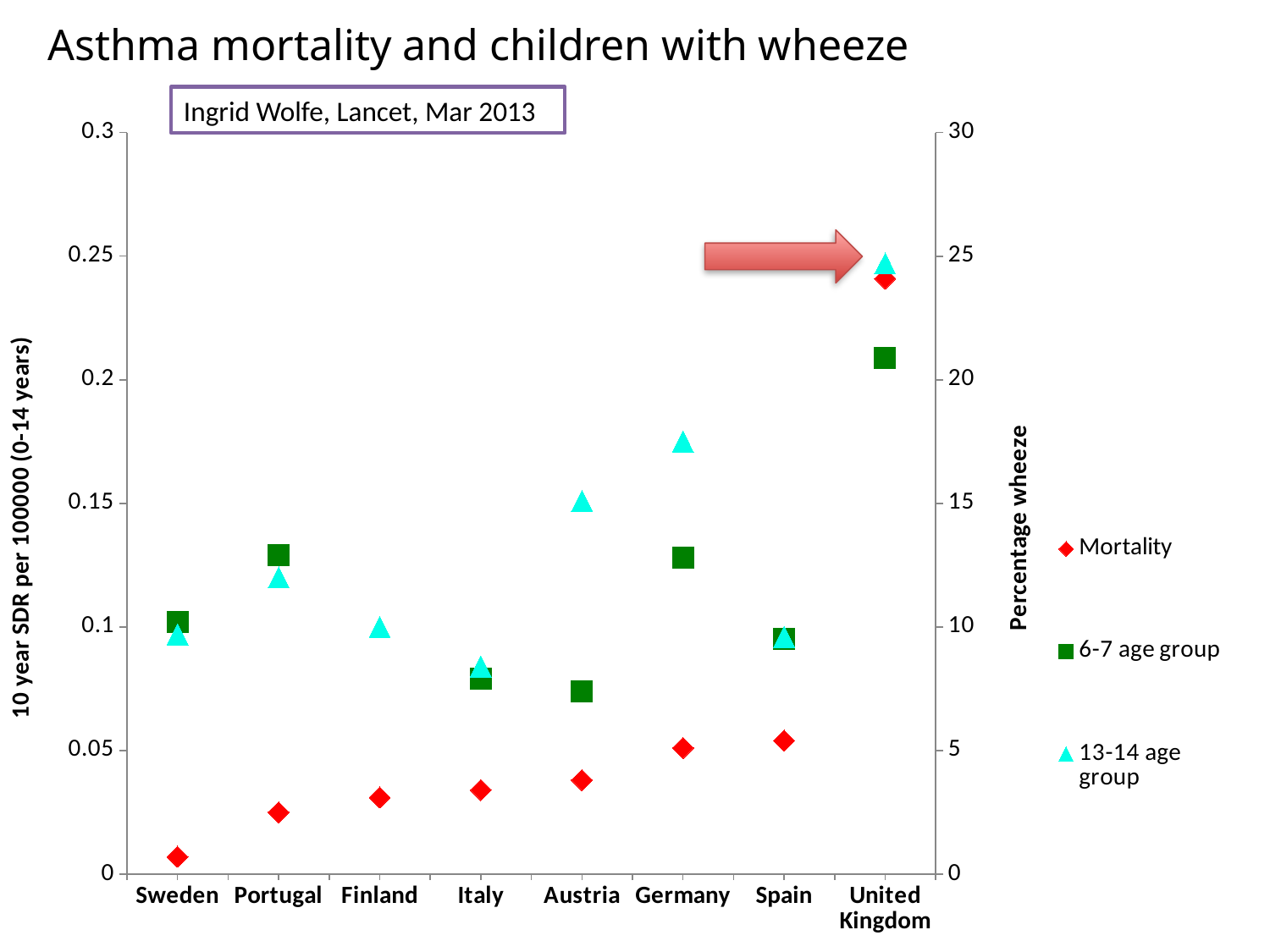
Is the 6-7 age group value for Austria greater or less than 10? less For Germany, which is larger: the 6-7 age group value or the 13-14 age group value? 13-14 age group Which country has the highest value for the 13-14 age group? United Kingdom What kind of chart is shown on the slide? scatter chart Is the Mortality value for United Kingdom greater or less than 0.2? greater Which country has the highest Mortality value? United Kingdom How many countries are plotted along the x axis? 8 What is the label of the right-hand vertical axis? Percentage wheeze How many series does the legend list? 3 Which country has the lowest Mortality value? Sweden Is the 13-14 age group value for Germany greater or less than 15? greater Do the Mortality values rise or fall moving from Sweden to United Kingdom along the x axis? rise